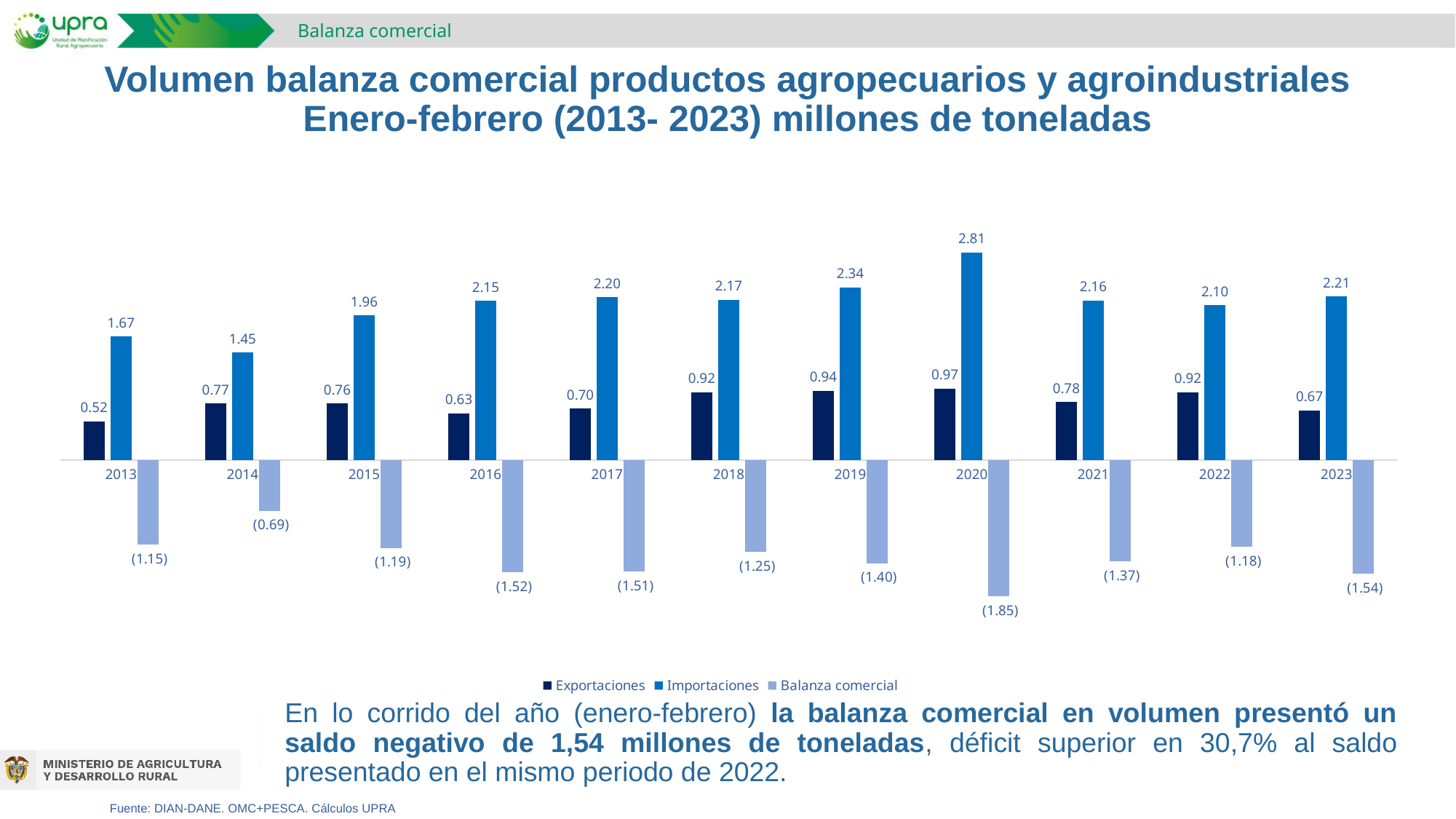
How many series does the legend list? 3 What is the difference between Importaciones and Exportaciones in 2023? 1.54 By how much did Importaciones increase from 2019 to 2020? 0.47 In which year is the Importaciones value lowest? 2014 What is the value of Importaciones for 2020? 2.81 What kind of chart is shown on the slide? Bar chart How many years are shown on the x axis of the chart? 11 In which year is the Exportaciones value lowest? 2013 Which year has the larger Exportaciones value, 2018 or 2021? 2018 What is the value of Exportaciones for 2013? 0.52 What is the value of Balanza comercial for 2023? (1.54) In which year is the Importaciones value highest? 2020